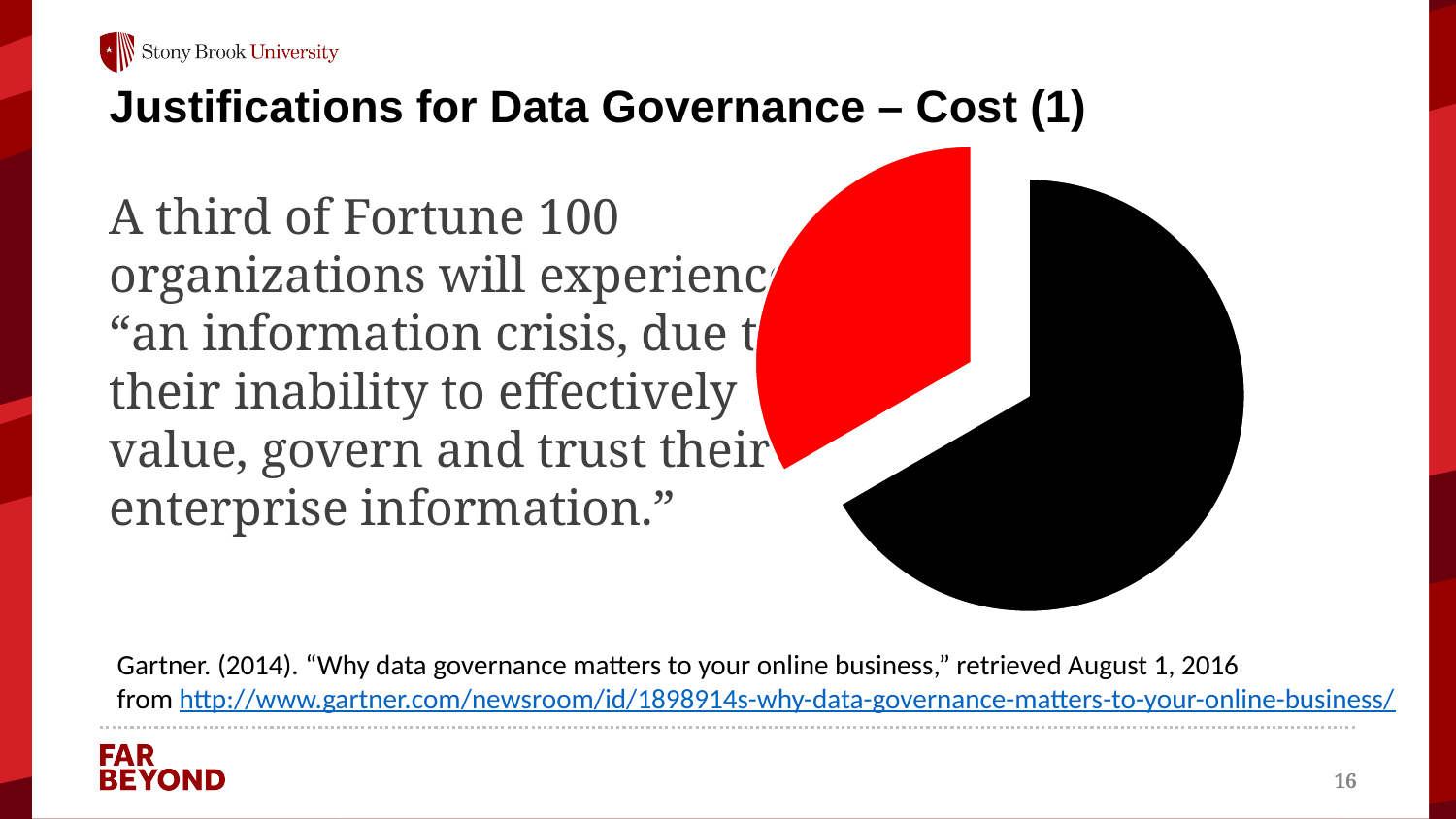
How many slices does the pie chart have? 2 According to the slide text, what share of Fortune 100 organizations does the red slice of the pie chart represent? a third Which slice of the pie chart is larger, the red one or the black one? the black one What kind of chart is shown on the slide? pie chart Is the red slice of the pie chart more or less than half of the pie? less What two colours are used for the slices of the pie chart? red and black Is the black slice of the pie chart more or less than half of the pie? more Which slice of the pie chart is smaller, the red one or the black one? the red one Which slice of the pie chart is pulled out (exploded) from the rest of the pie? the red slice